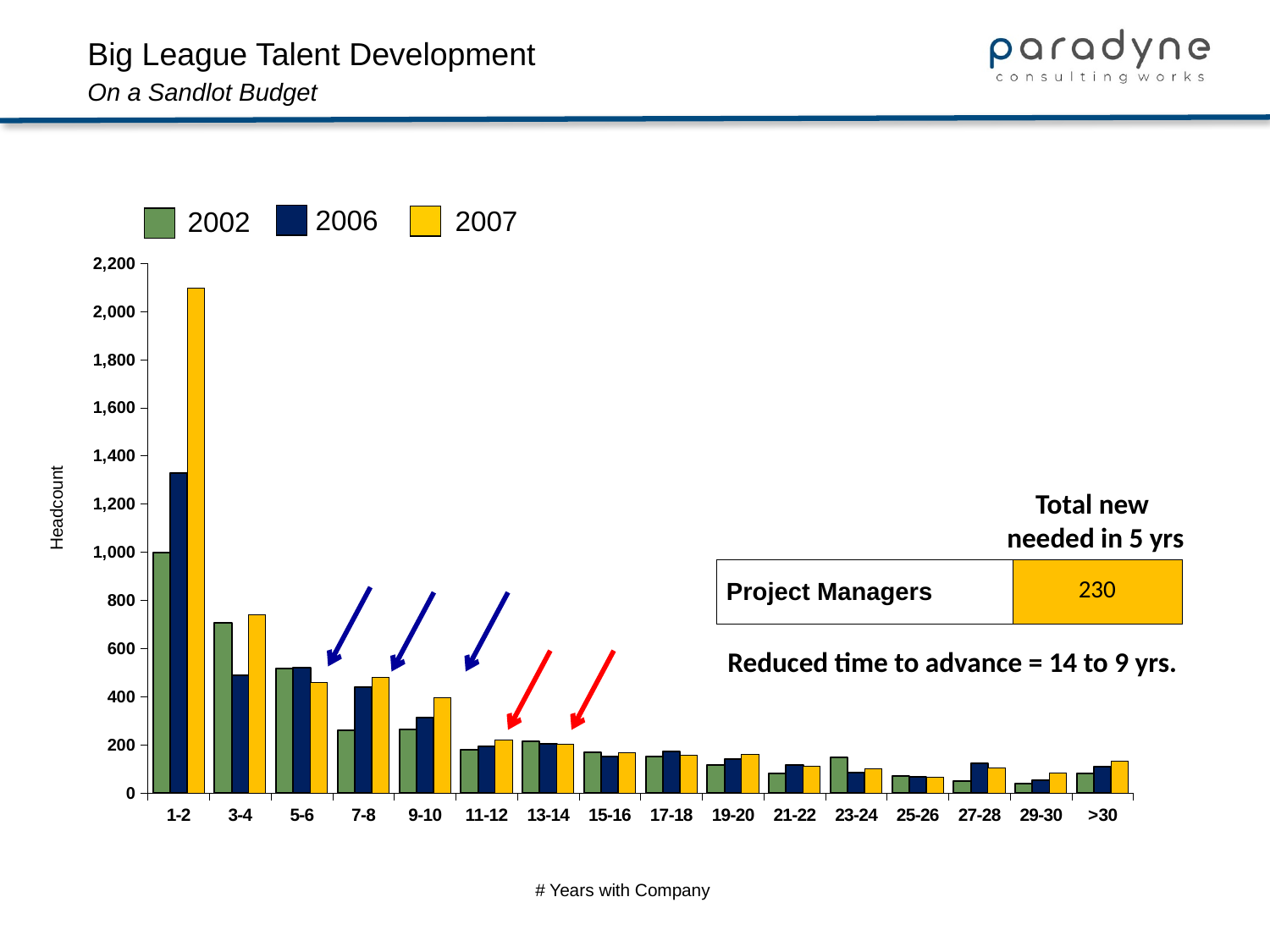
Is the 2007 headcount for the 1-2 years category greater or less than 2,000? greater What is the label of the x axis? # Years with Company Which category has the highest 2002 headcount? 1-2 How many series does the legend list? 3 How many year-range categories are shown on the x axis? 16 What is the label of the y axis? Headcount Which category has the highest 2007 headcount? 1-2 Which is larger for the 7-8 years category, the 2002 headcount or the 2007 headcount? 2007 What kind of chart is shown on the slide? bar chart Is the 2007 headcount for the 3-4 years category greater or less than 800? less Is the 2006 headcount for the 1-2 years category greater or less than 1,200? greater Which is larger for the 3-4 years category, the 2002 headcount or the 2006 headcount? 2002